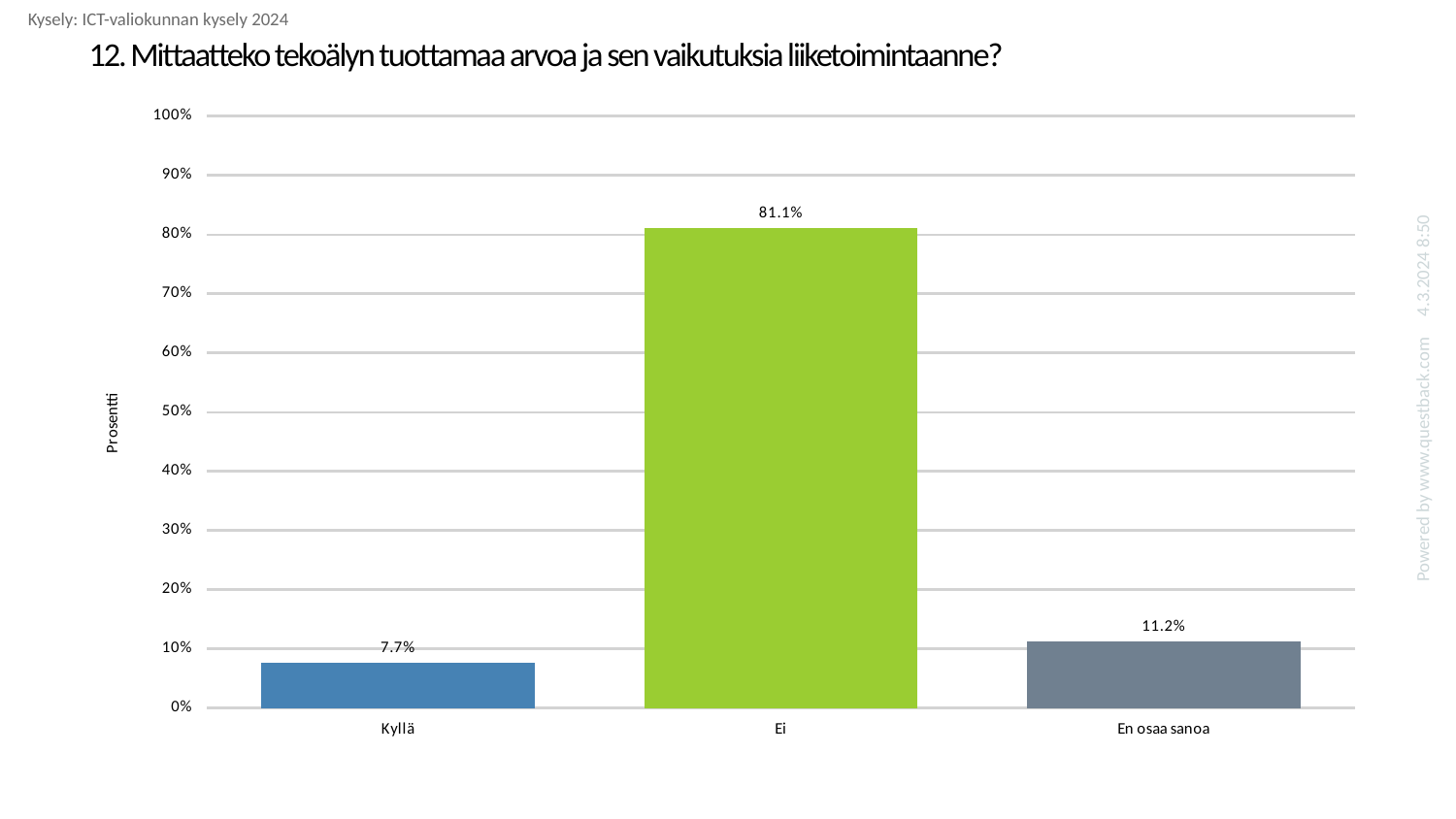
What is the difference between the values for "Ei" and "En osaa sanoa"? 69.9% Which is larger, the value for "Kyllä" or the value for "En osaa sanoa"? En osaa sanoa What is the label of the y axis? Prosentti How many categories are shown on the x axis? 3 What kind of chart is shown on the slide? bar chart Which category has the highest value? Ei What is the difference between the values for "En osaa sanoa" and "Kyllä"? 3.5% Is the value for "Ei" greater or less than 80%? greater What is the value for "En osaa sanoa"? 11.2% Which category has the lowest value? Kyllä What is the value for "Kyllä"? 7.7% What is the value for "Ei"? 81.1%